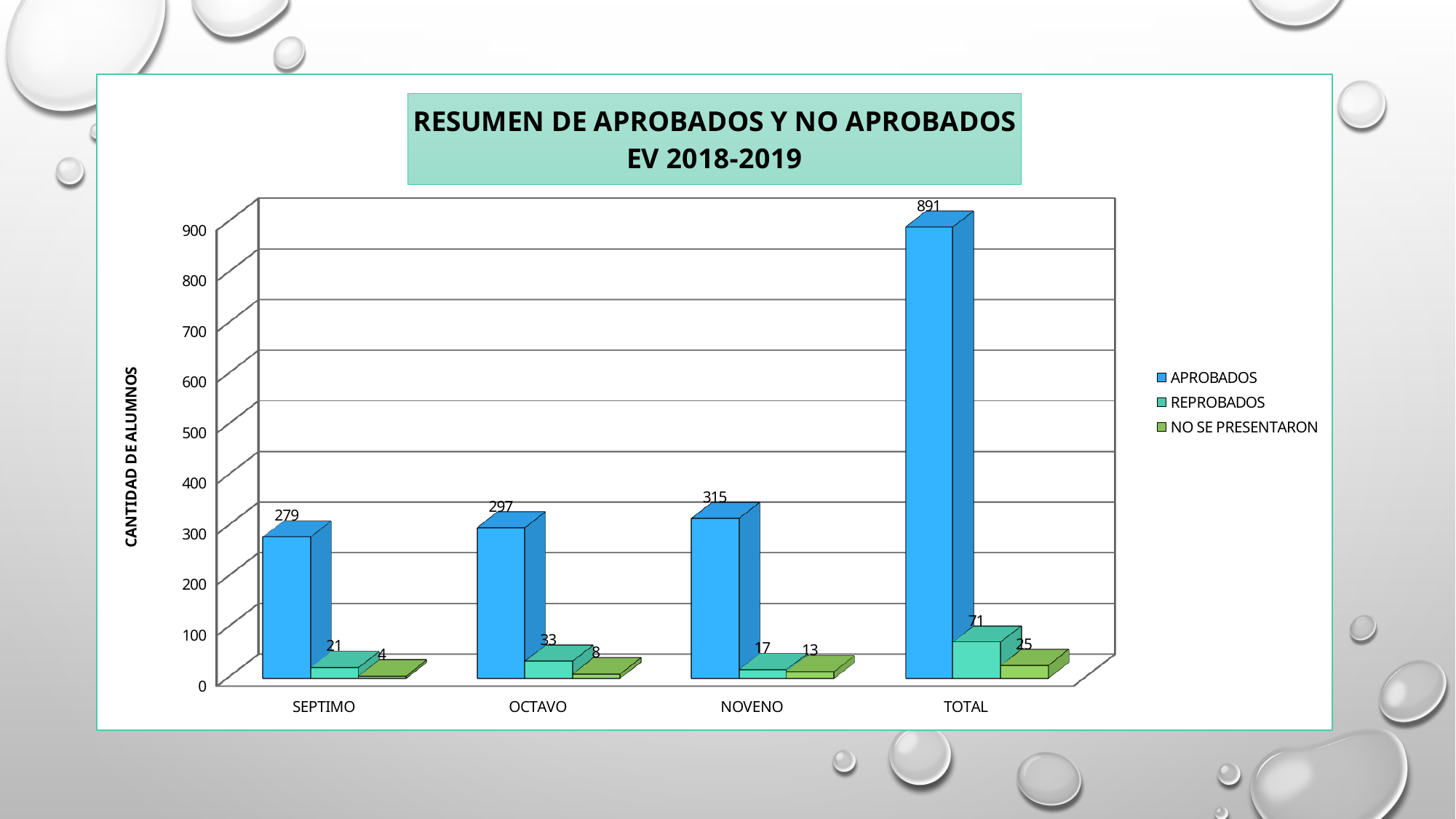
What kind of chart is shown on the slide? Bar chart What is the value for NO SE PRESENTARON in NOVENO? 13 Is the APROBADOS value for OCTAVO greater or less than 200? greater How many series does the legend list? 3 How many categories are shown on the x axis? 4 Among SEPTIMO, OCTAVO and NOVENO, which has the lowest REPROBADOS value? NOVENO What is the value for APROBADOS in SEPTIMO? 279 Which is larger, the REPROBADOS value for SEPTIMO or for OCTAVO? OCTAVO What is the value for APROBADOS in TOTAL? 891 Which category has the highest APROBADOS value? TOTAL What is the difference between the APROBADOS values for NOVENO and SEPTIMO? 36 What is the value for REPROBADOS in OCTAVO? 33